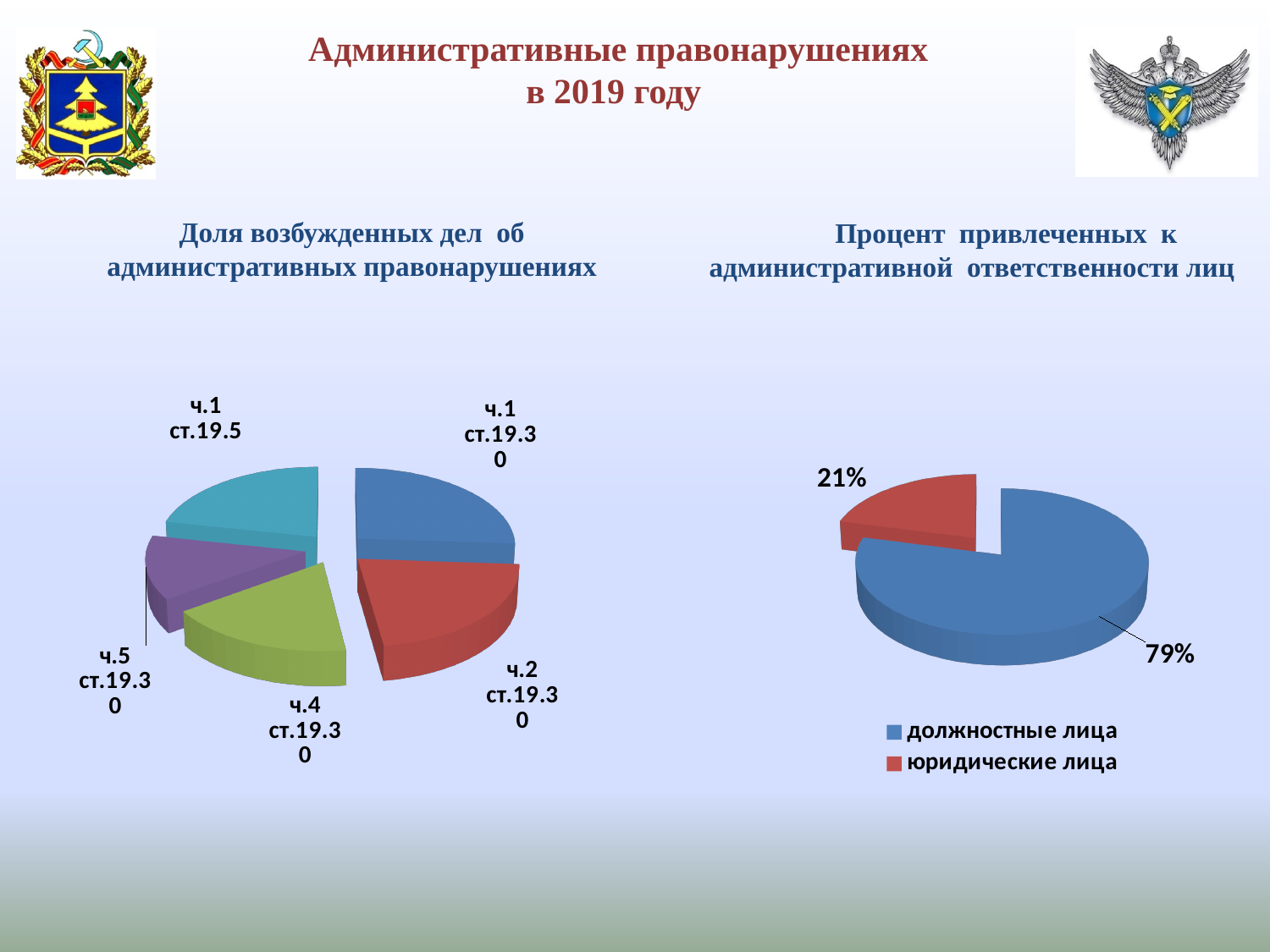
What kind of chart is the chart titled 'Доля возбужденных дел об административных правонарушениях'? pie chart What kind of chart is the chart titled 'Процент привлеченных к административной ответственности лиц'? pie chart In the chart 'Процент привлеченных к административной ответственности лиц', what is the share for юридические лица? 21% How many entries does the legend of the chart 'Процент привлеченных к административной ответственности лиц' list? 2 In the chart 'Процент привлеченных к административной ответственности лиц', what colour is the slice for юридические лица? red In the chart 'Процент привлеченных к административной ответственности лиц', by how many percentage points does должностные лица exceed юридические лица? 58 In the chart 'Процент привлеченных к административной ответственности лиц', which is larger: должностные лица or юридические лица? должностные лица How many slices does the chart 'Доля возбужденных дел об административных правонарушениях' have? 5 In the chart 'Процент привлеченных к административной ответственности лиц', which category has the largest share? должностные лица In the chart 'Процент привлеченных к административной ответственности лиц', what is the share for должностные лица? 79% In the chart 'Доля возбужденных дел об административных правонарушениях', which slice is the smallest? ч.5 ст.19.30 In the chart 'Процент привлеченных к административной ответственности лиц', which category has the smallest share? юридические лица